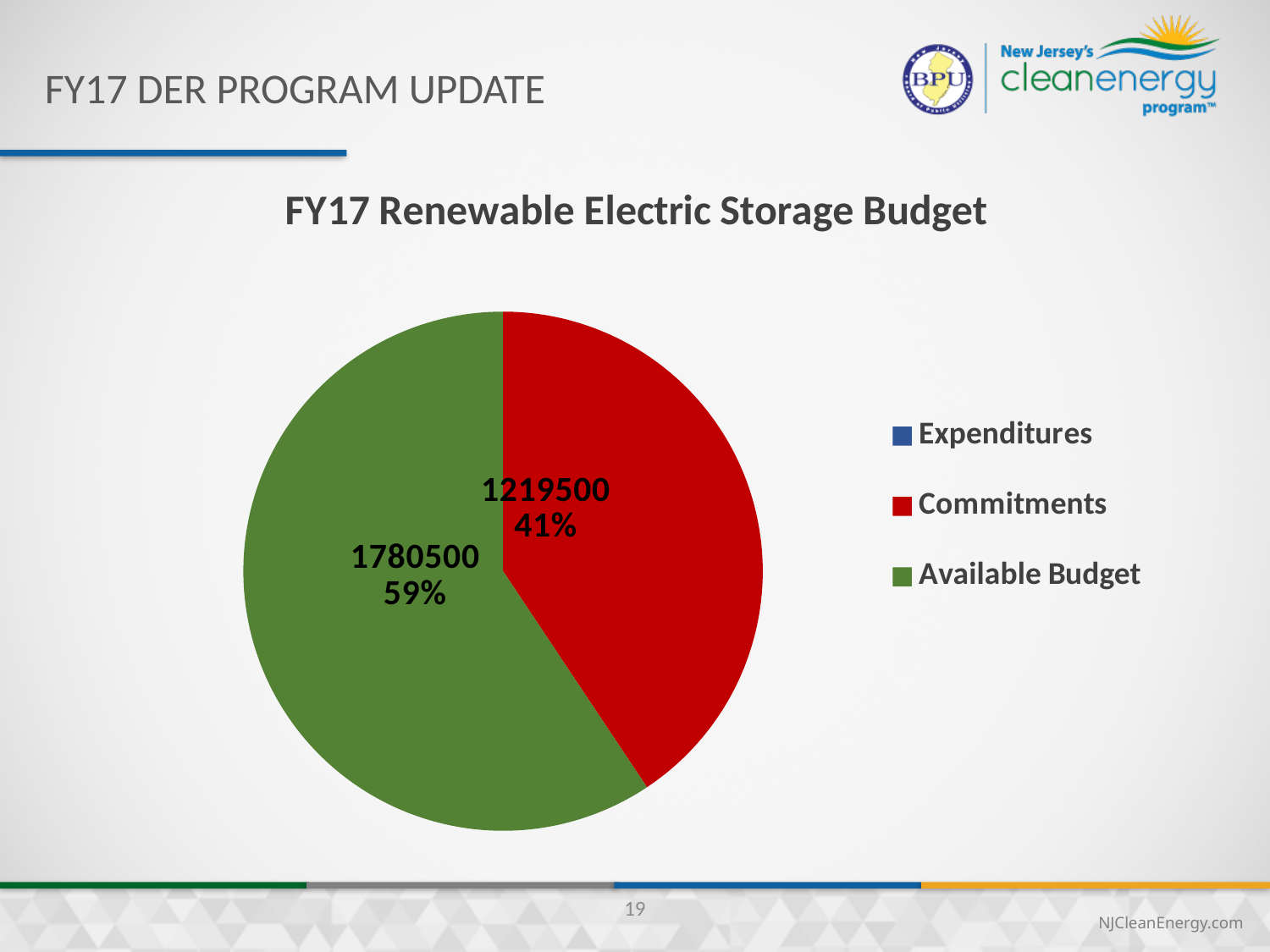
What share of the pie does Available Budget represent? 59% What share of the pie does Commitments represent? 41% Which is larger, Commitments or Available Budget? Available Budget What colour represents Available Budget in the legend? green What is the total of the Commitments and Available Budget values? 3000000 What is the difference between the Available Budget value and the Commitments value? 561000 What is the value shown for Commitments? 1219500 How many series does the legend list? 3 Which slice is the largest in the pie chart? Available Budget What is the value shown for Available Budget? 1780500 What is the title of the chart? FY17 Renewable Electric Storage Budget What kind of chart is shown on the slide? pie chart